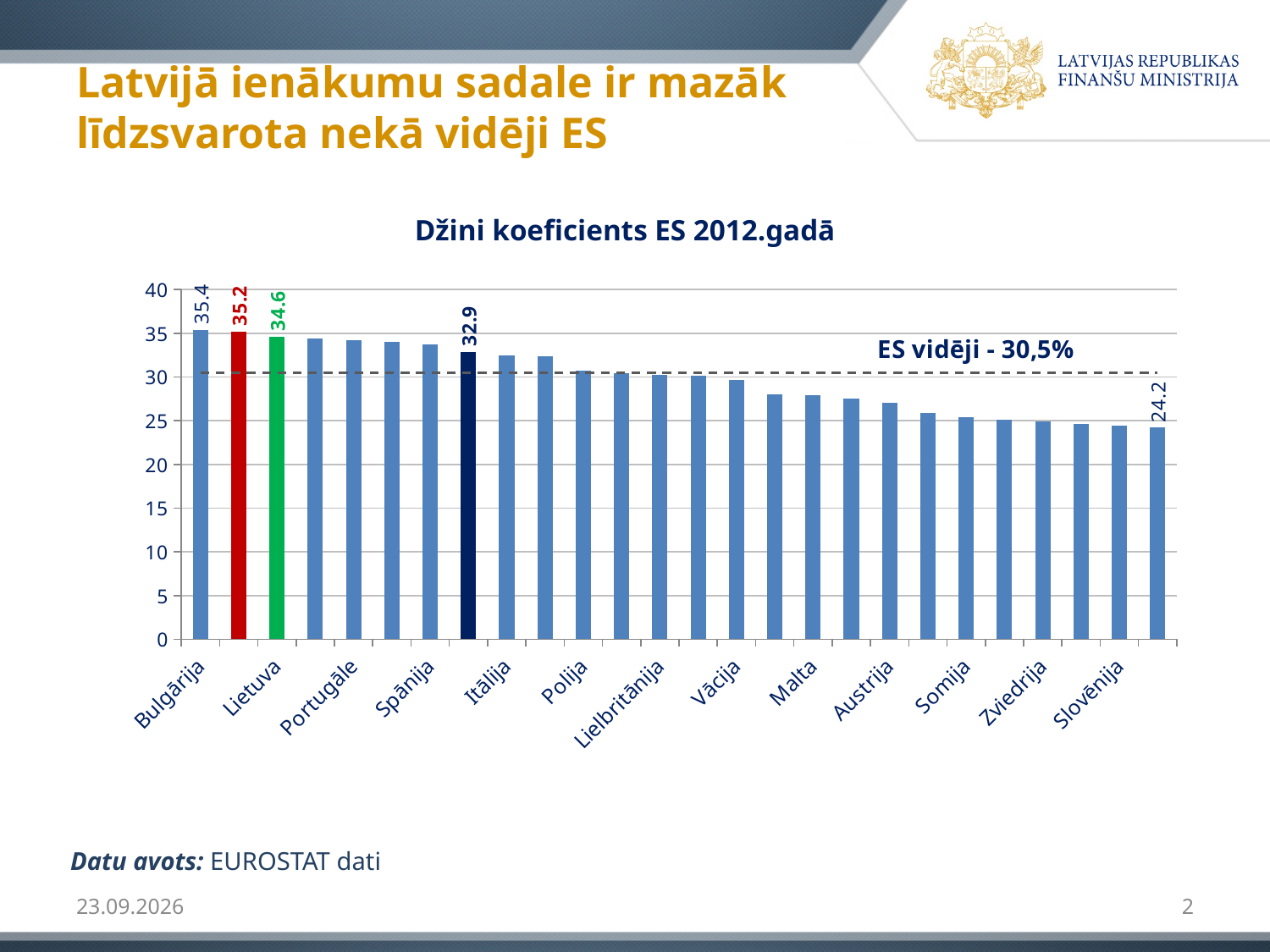
What is the Gini coefficient value shown for Lietuva? 34.6 Which has a higher Gini coefficient, Bulgārija or Lietuva? Bulgārija What is the difference between the values for Bulgārija and Lietuva? 0.8 What is the lowest value shown in the chart? 24.2 What is the EU average (ES vidēji) indicated by the dashed line? 30,5% What is the Gini coefficient value shown for Bulgārija? 35.4 What value is shown for the red bar? 35.2 What type of chart is shown on the slide? bar chart Which country has the highest Gini coefficient in the chart? Bulgārija What is the title of the chart? Džini koeficients ES 2012.gadā Do the values rise or fall from left to right along the x axis? fall Is the value for Malta greater or less than 30? less